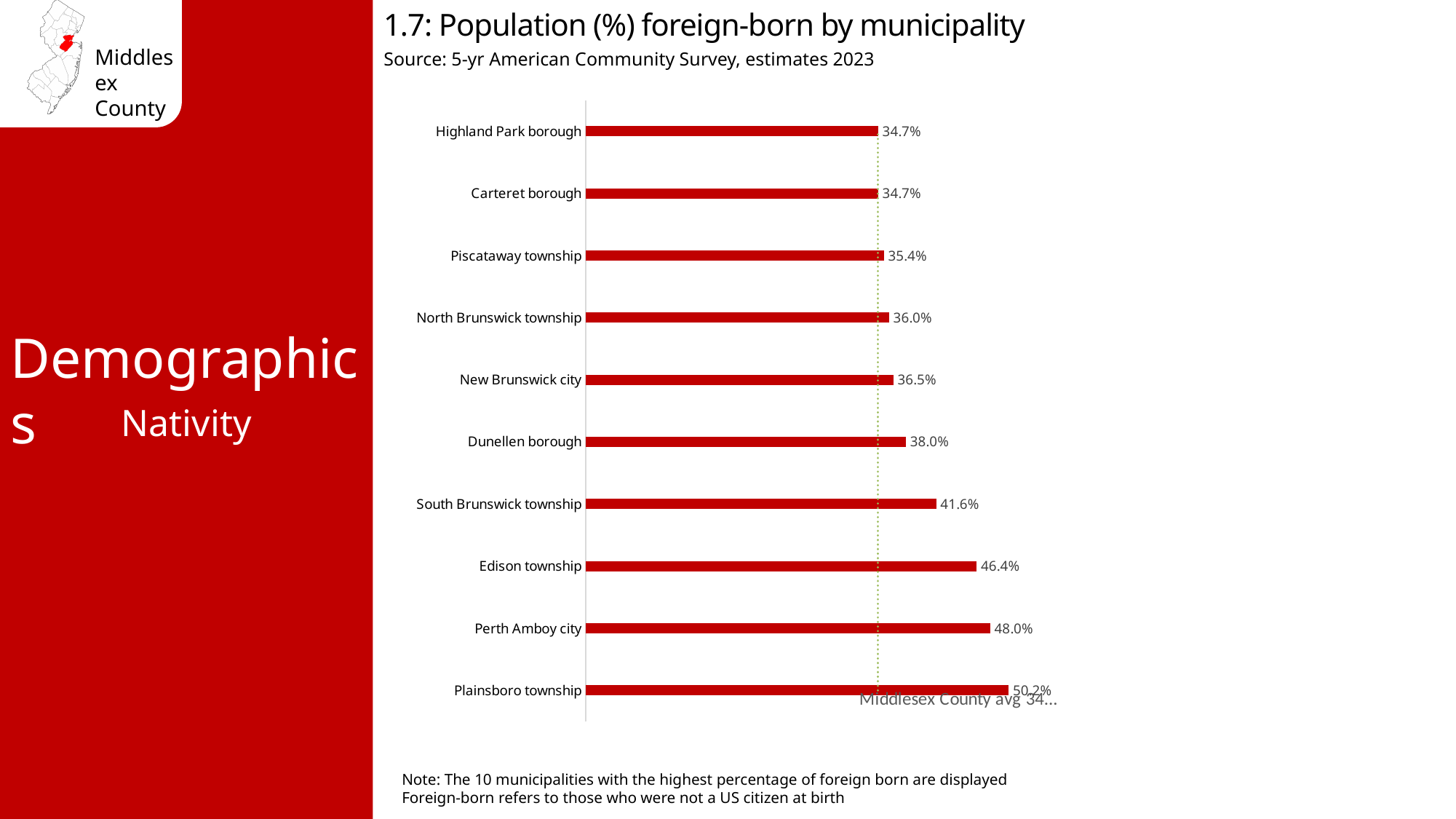
How many municipalities are shown in the chart? 10 What value is shown for Dunellen borough? 38.0% Which has a higher foreign-born percentage, Edison township or South Brunswick township? Edison township What is the difference between the values for South Brunswick township and Piscataway township? 6.2% What type of chart is used on this slide? Bar chart What is the source of the data shown in the chart? 5-yr American Community Survey, estimates 2023 What is the foreign-born percentage shown for New Brunswick city? 36.5% What is the title of the chart? 1.7: Population (%) foreign-born by municipality What is the difference between the foreign-born percentages of Plainsboro township and Perth Amboy city? 2.2% Which has a higher foreign-born percentage, North Brunswick township or Dunellen borough? Dunellen borough Which municipality has the highest percentage of foreign-born population? Plainsboro township What percentage of the population is foreign-born in Edison township? 46.4%